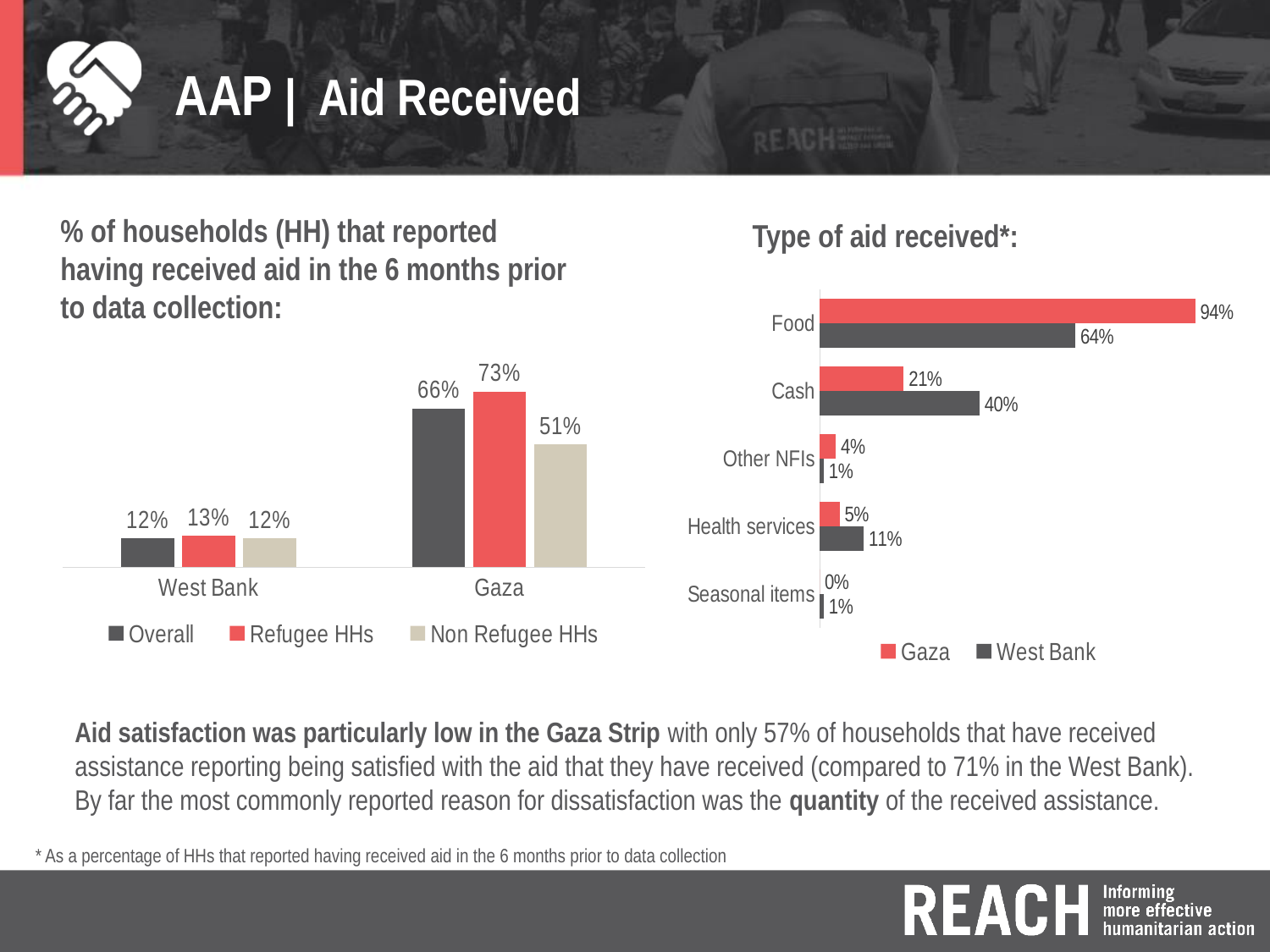
In the left chart (% of households that reported having received aid), what is the difference between the Overall values for Gaza and the West Bank? 54 percentage points In the right chart (Type of aid received), what is the value for Food in Gaza? 94% In the right chart (Type of aid received), how many types of aid are shown? 5 In the left chart (% of households that reported having received aid), how many series does the legend list? 3 In the right chart (Type of aid received), which type of aid has the lowest value for Gaza? Seasonal items In the left chart (% of households that reported having received aid), what is the value for Refugee HHs in Gaza? 73% In the left chart (% of households that reported having received aid), which series has the highest value in Gaza? Refugee HHs In the left chart (% of households that reported having received aid), what is the value for Non Refugee HHs in the West Bank? 12% In the right chart (Type of aid received), is the value for Health services larger in Gaza or in the West Bank? West Bank In the right chart (Type of aid received), what is the difference between the Gaza and West Bank values for Food? 30 percentage points In the right chart (Type of aid received), which type of aid has the highest value for the West Bank? Food In the right chart (Type of aid received), what is the value for Cash in the West Bank? 40%